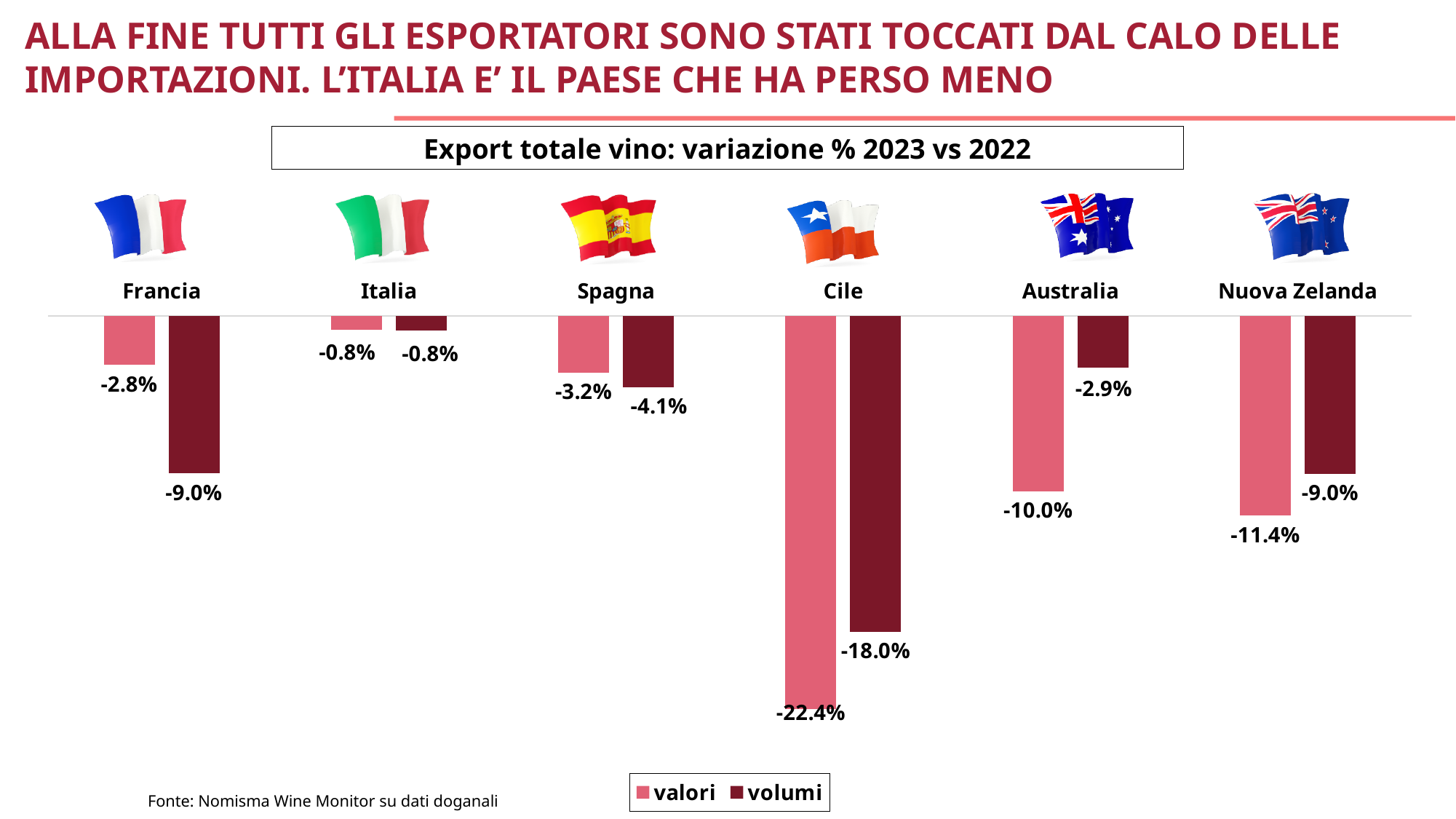
What is the 'valori' value for Nuova Zelanda? -11.4% What is the difference between the 'valori' and 'volumi' values for Francia? 6.2 percentage points What is the 'volumi' value for Cile? -18.0% What is the 'valori' value for Francia? -2.8% Which country has the highest 'volumi' value? Italia How many countries are shown in the chart? 6 What kind of chart is shown on the slide? Bar chart Which country has the lowest 'valori' value? Cile What is the 'volumi' value for Australia? -2.9% Which is larger, the 'valori' value for Australia or the 'valori' value for Spagna? Spagna How many series does the legend list? 2 What is the title of the chart? Export totale vino: variazione % 2023 vs 2022